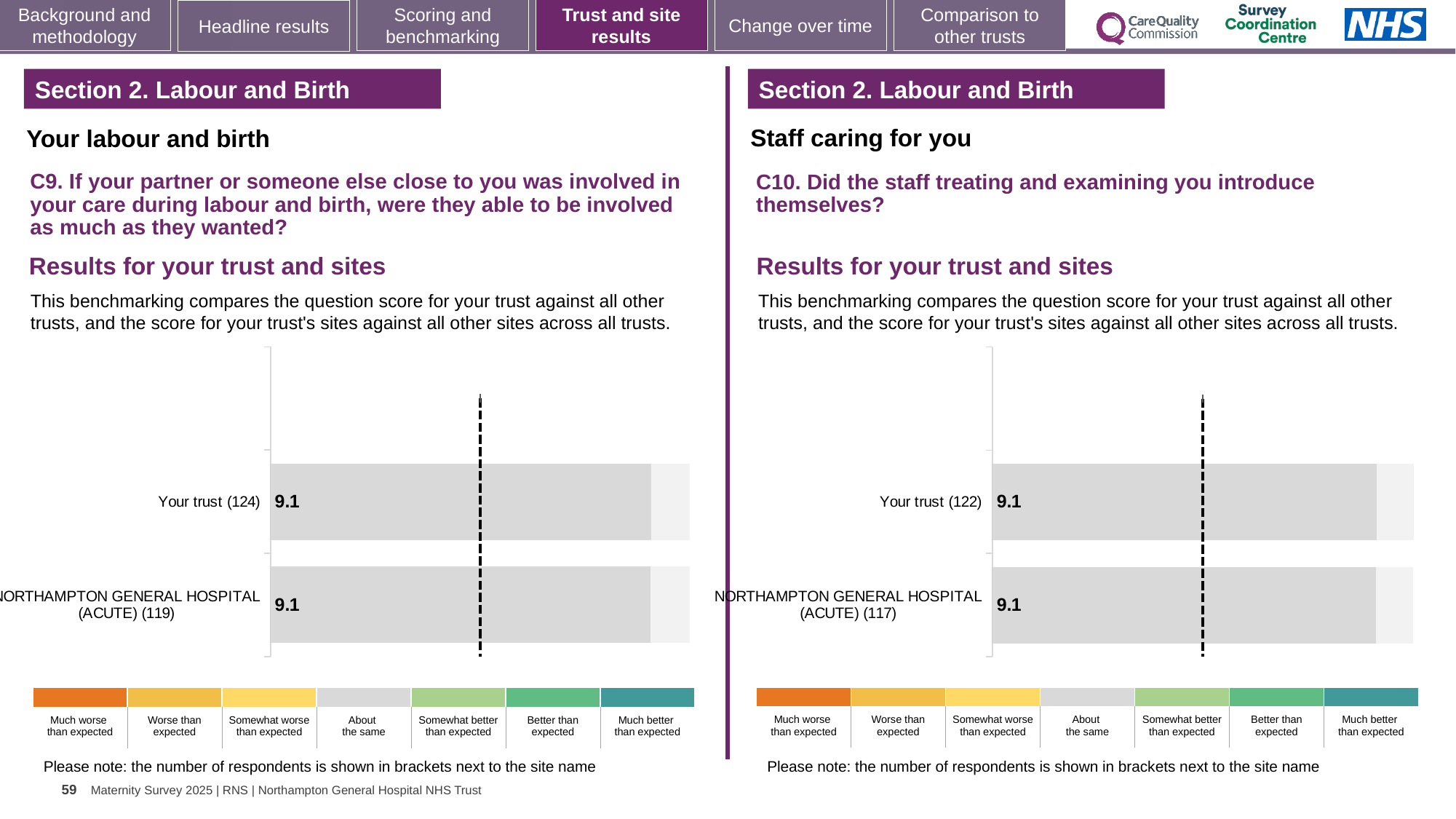
In the left chart (C9), what is the score for Your trust? 9.1 In the left chart (C9), what is the score for NORTHAMPTON GENERAL HOSPITAL (ACUTE)? 9.1 In the right chart (C10), how many respondents are shown in brackets for Your trust? 122 In the left chart (C9), how many respondents are shown in brackets for NORTHAMPTON GENERAL HOSPITAL (ACUTE)? 119 How many categories does the colour key below the right chart (C10) list? 7 In the left chart (C9), what is the difference between the score for Your trust and the score for NORTHAMPTON GENERAL HOSPITAL (ACUTE)? 0.0 In the right chart (C10), what is the score for Your trust? 9.1 In the right chart (C10), how many respondents are shown in brackets for NORTHAMPTON GENERAL HOSPITAL (ACUTE)? 117 In the right chart (C10), what is the score for NORTHAMPTON GENERAL HOSPITAL (ACUTE)? 9.1 What kind of chart is used in the left chart (C9)? Bar chart In the left chart (C9), how many respondents are shown in brackets for Your trust? 124 How many bars are plotted in the right chart (C10)? 2